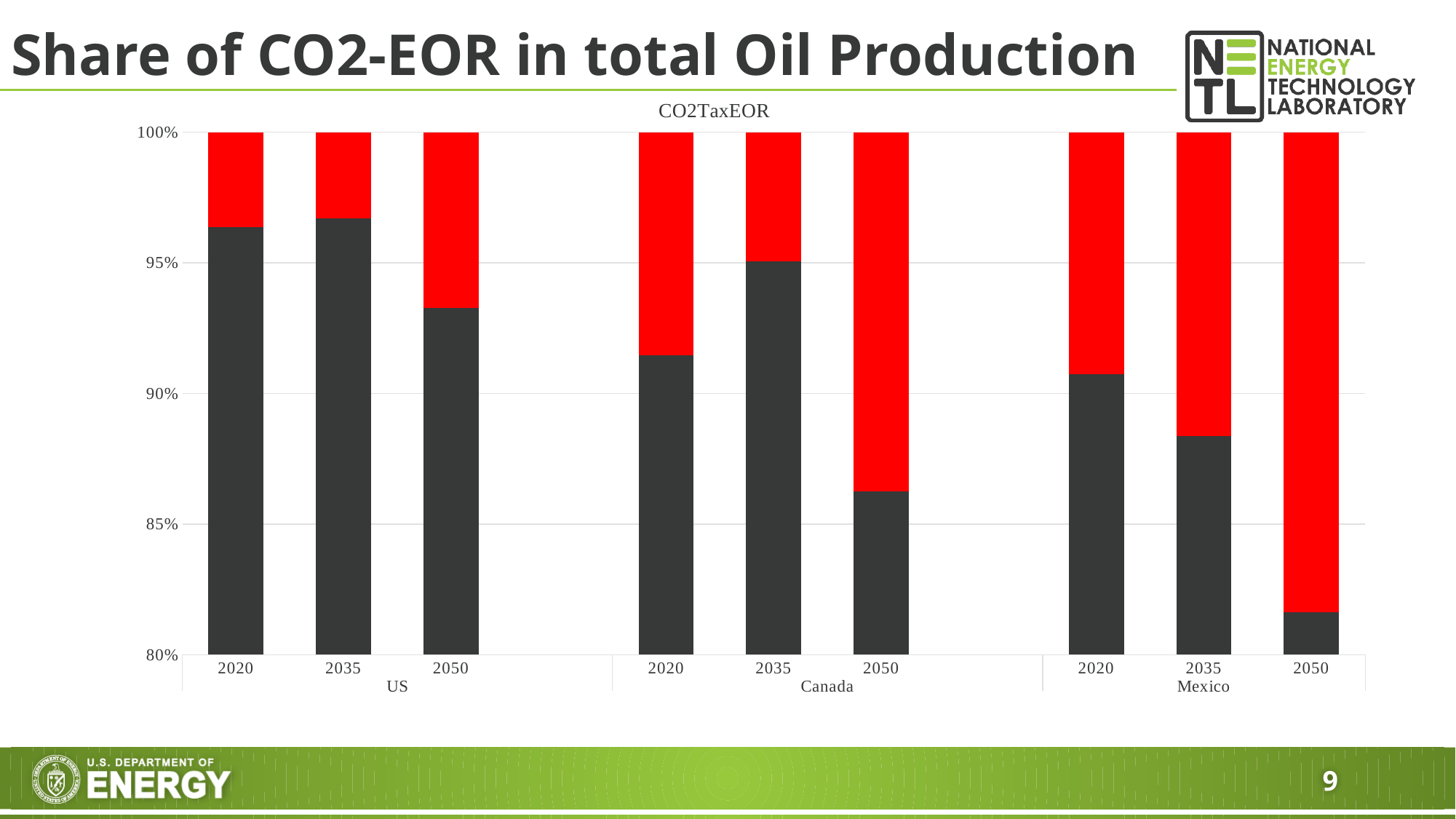
Which bar has the largest red segment? Mexico 2050 Is the top of the dark grey segment for US 2050 greater or less than 95%? less Is the dark grey segment for Canada 2020 larger or smaller than the dark grey segment for Canada 2050? larger For Mexico, does the dark grey segment rise or fall from 2020 to 2050? fall Which bar has the smallest dark grey segment? Mexico 2050 Is the top of the dark grey segment for US 2020 greater or less than 95%? greater What is the title printed above the chart? CO2TaxEOR How many country groups are shown on the x axis? 3 Is the top of the dark grey segment for Canada 2050 greater or less than 90%? less What kind of chart is shown on the slide? stacked bar chart How many bars are plotted in the chart? 9